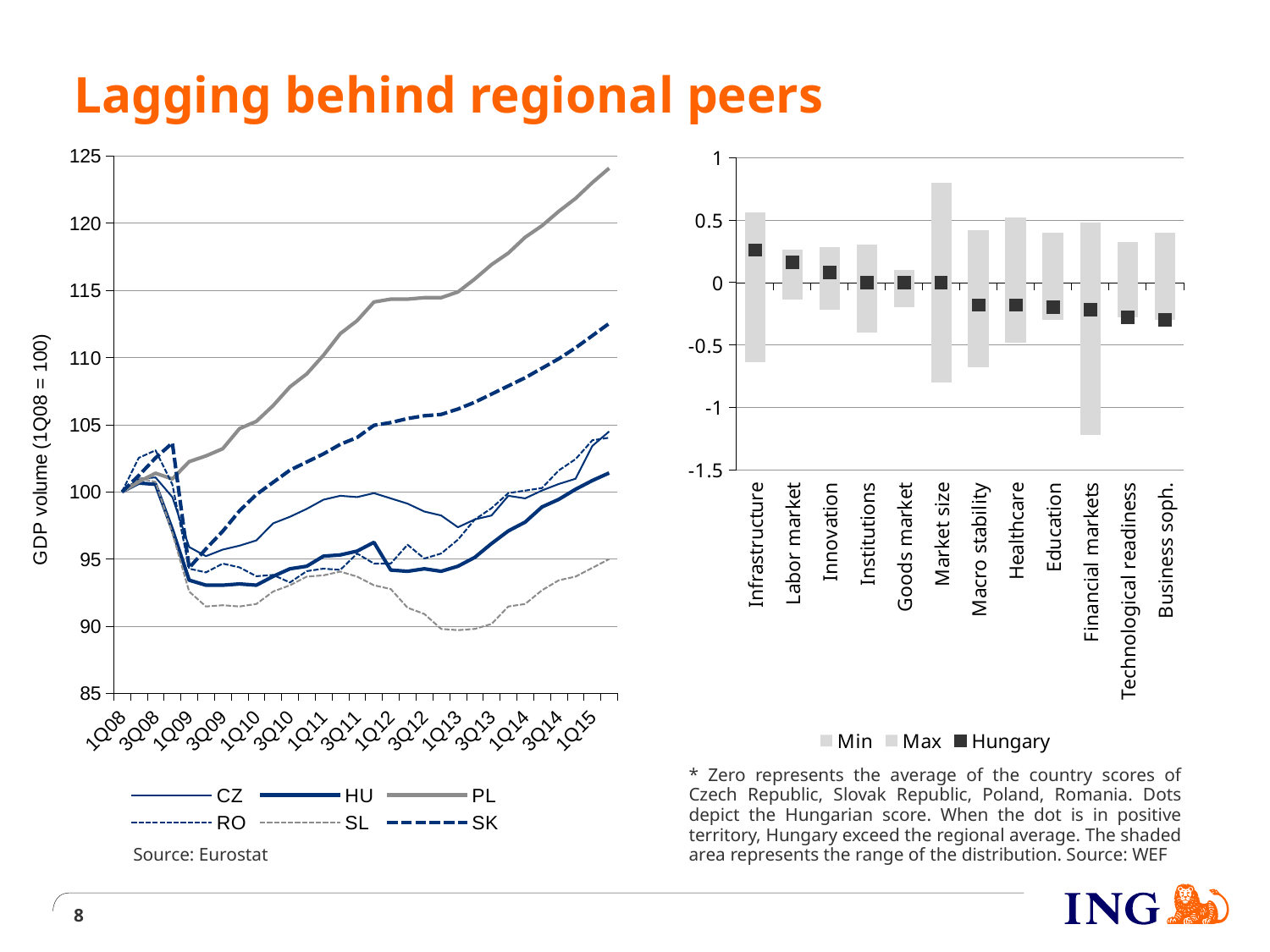
How many categories are shown on the x axis of the right chart (Min/Max/Hungary)? 12 In the left chart (GDP volume), which is larger at 1Q15, HU or SL? HU In the left chart (GDP volume), is the value for SK at 1Q15 greater or less than 110? greater In the right chart (Min/Max/Hungary), is the Hungary value for Healthcare greater or less than 0? less In the left chart (GDP volume), which series is lowest at 1Q15? SL In the left chart (GDP volume), which series is highest at 1Q15? PL In the left chart (GDP volume), does the PL series rise or fall from 1Q09 to 1Q15? rise How many series does the legend of the left chart (GDP volume) list? 6 How many entries does the legend of the right chart (Min/Max/Hungary) list? 3 What kind of chart is the left chart (GDP volume)? line chart In the right chart (Min/Max/Hungary), for which category is the Hungary dot highest? Infrastructure In the left chart (GDP volume), is the value for PL at 1Q15 greater or less than 120? greater